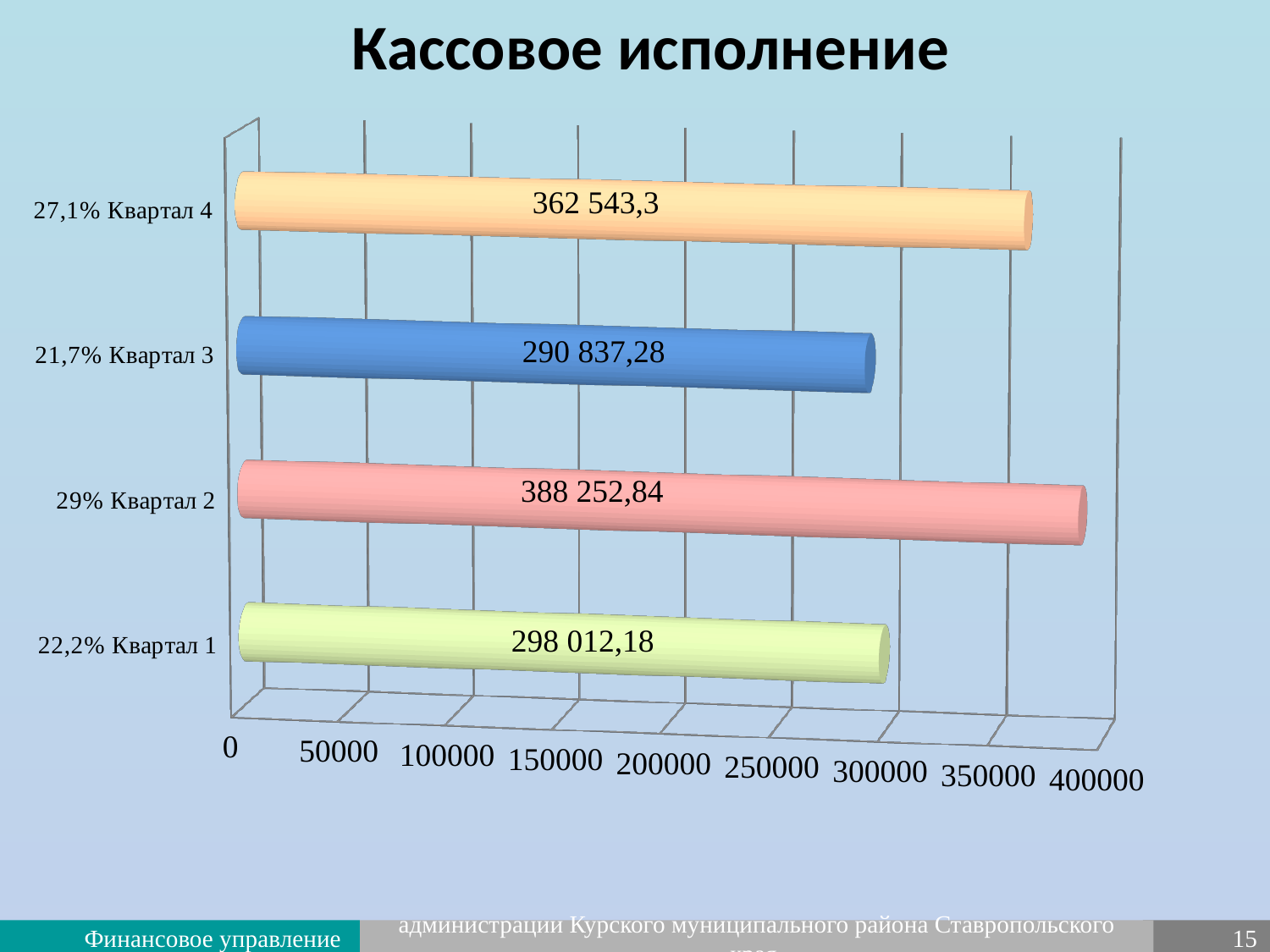
What kind of chart is shown on the slide? bar chart How many quarters are shown in the chart? 4 What is the difference between the values for Квартал 2 and Квартал 1? 90 240,66 What is the value for Квартал 4? 362 543,3 Which quarter has the highest value? Квартал 2 Is the value for Квартал 4 greater or less than 350000? greater What percentage is shown next to the label for Квартал 2? 29% What is the value for Квартал 3? 290 837,28 What is the difference between the values for Квартал 4 and Квартал 3? 71 706,02 Which quarter has the lowest value? Квартал 3 What is the value for Квартал 1? 298 012,18 Which is larger, the value for Квартал 4 or the value for Квартал 3? Квартал 4